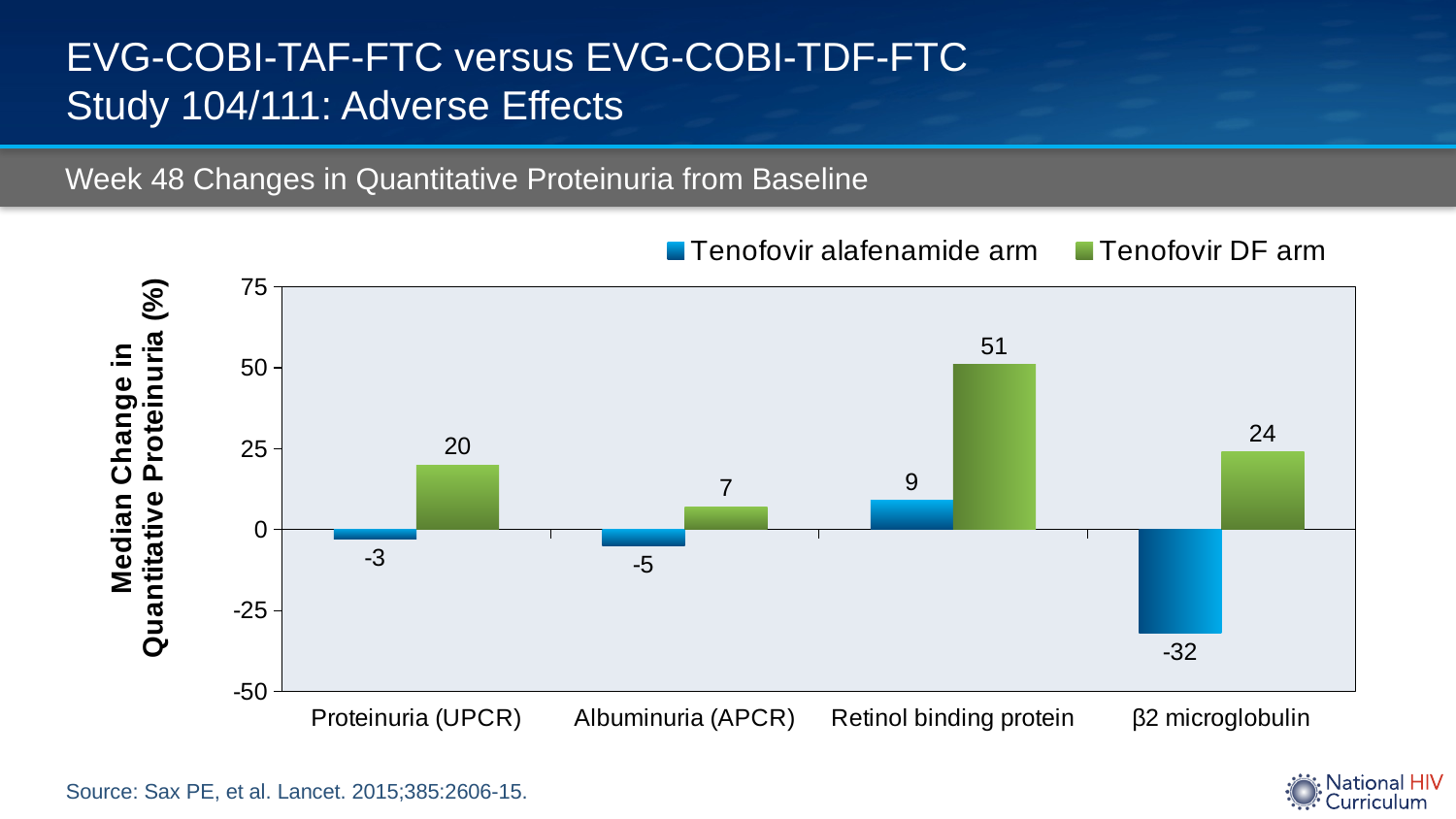
What is the value for the Tenofovir alafenamide arm for Albuminuria (APCR)? -5 What kind of chart is shown on the slide? Bar chart What is the value for the Tenofovir DF arm for Proteinuria (UPCR)? 20 Which is larger for Albuminuria (APCR): the Tenofovir alafenamide arm or the Tenofovir DF arm? Tenofovir DF arm What is the value for the Tenofovir alafenamide arm for β2 microglobulin? -32 What is the y-axis label of the chart? Median Change in Quantitative Proteinuria (%) Which category has the highest value for the Tenofovir DF arm? Retinol binding protein How many series does the legend list? 2 Which category has the lowest value for the Tenofovir alafenamide arm? β2 microglobulin How many categories are shown on the x axis? 4 What is the difference between the Tenofovir DF arm and the Tenofovir alafenamide arm for Retinol binding protein? 42 What is the value for the Tenofovir DF arm for Retinol binding protein? 51